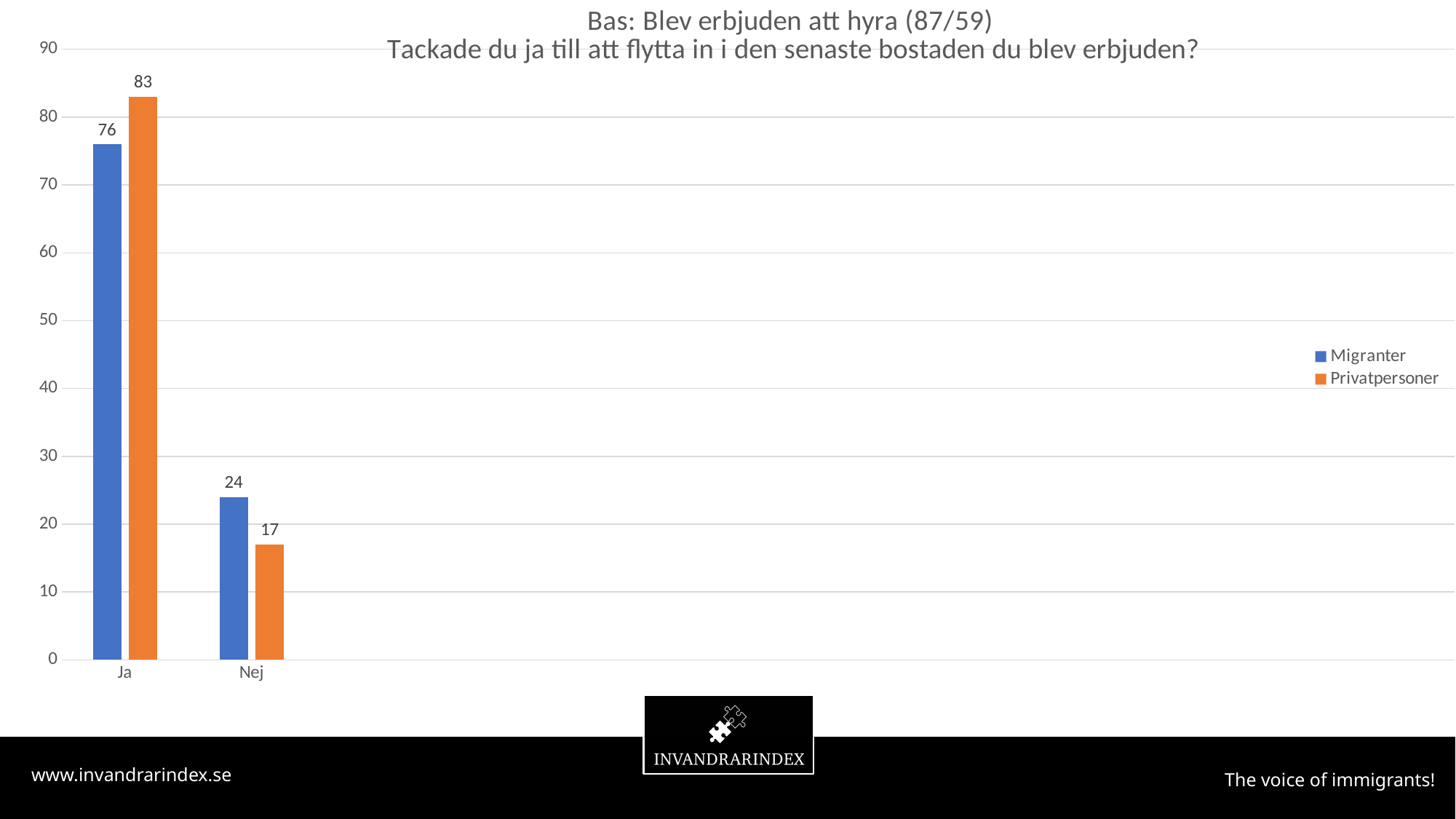
What is the value for Migranter in the Ja category? 76 What is the value for Privatpersoner in the Nej category? 17 Which category has the highest value for Privatpersoner? Ja How many categories are shown on the x axis? 2 In the Nej category, which series has the larger value, Migranter or Privatpersoner? Migranter What is the difference between the Privatpersoner and Migranter values in the Ja category? 7 What is the value for Migranter in the Nej category? 24 Which colour represents the Privatpersoner series? Orange What kind of chart is shown on the slide? Bar chart Which category has the lowest value for Migranter? Nej What is the value for Privatpersoner in the Ja category? 83 How many series does the legend list? 2